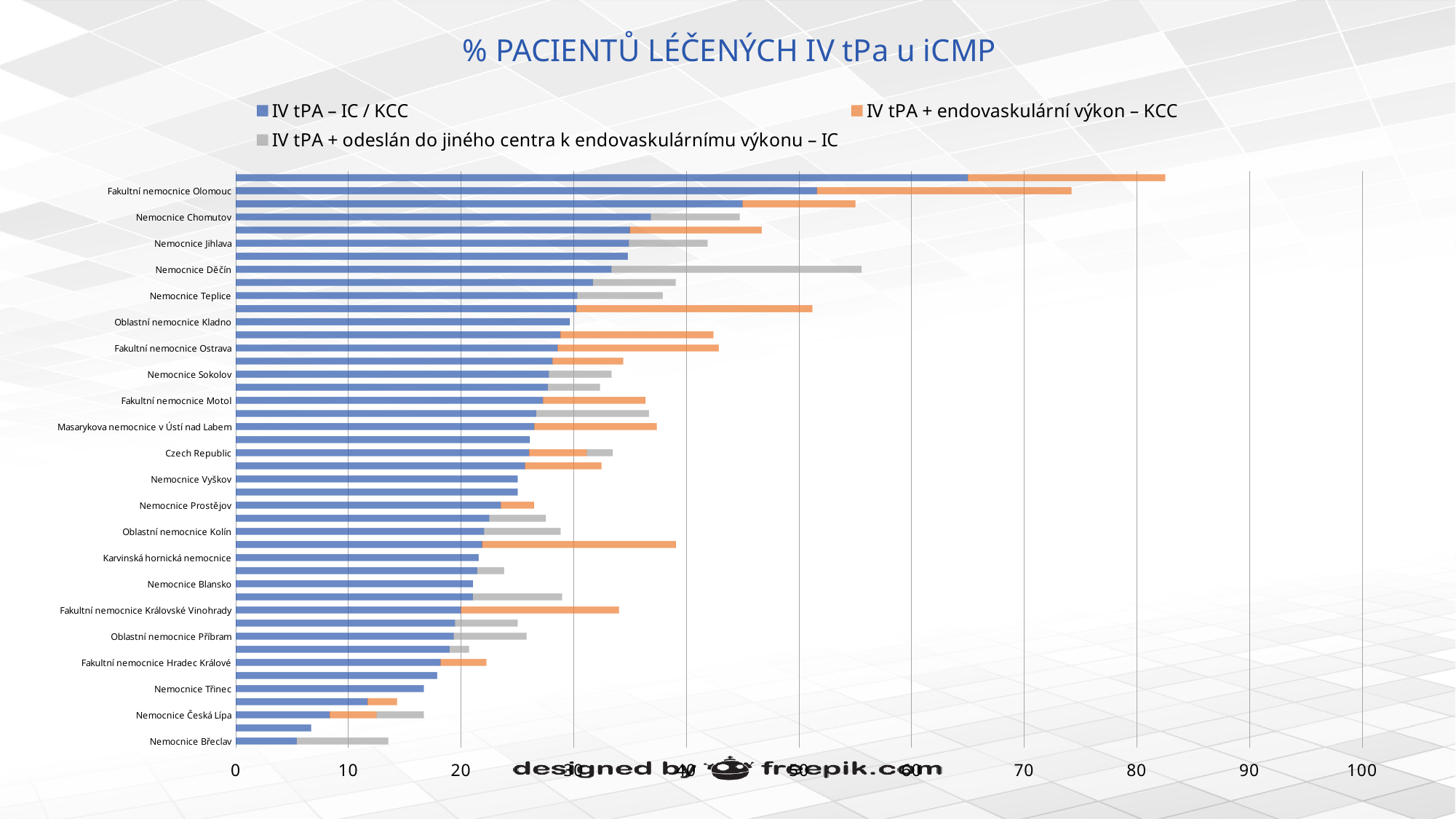
What type of chart is shown on the slide? bar chart Which has the larger IV tPA – IC / KCC value, Fakultní nemocnice Olomouc or Nemocnice Břeclav? Fakultní nemocnice Olomouc Is the total length of the bar for Nemocnice Česká Lípa greater or less than 20? less Is the IV tPA – IC / KCC value for Oblastní nemocnice Kladno greater or less than 40? less Is the IV tPA – IC / KCC value for Fakultní nemocnice Olomouc greater or less than 40? greater How many series does the legend list? 3 Which legend entry is shown in orange? IV tPA + endovaskulární výkon – KCC Do the IV tPA – IC / KCC values rise or fall going from the top of the chart to the bottom? fall What is the title of the chart? % PACIENTŮ LÉČENÝCH IV tPa u iCMP